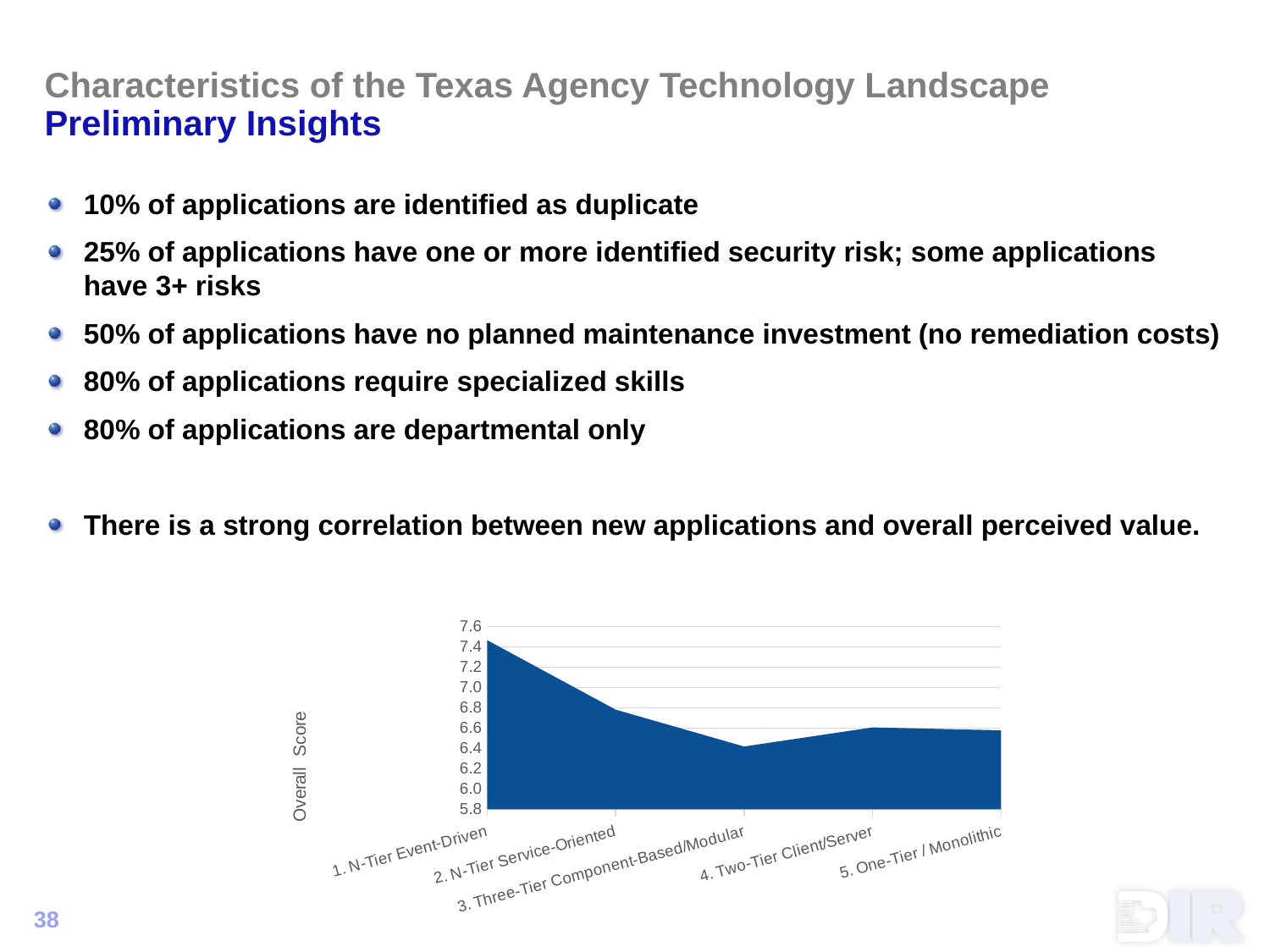
Which has a higher overall score, 1. N-Tier Event-Driven or 2. N-Tier Service-Oriented? 1. N-Tier Event-Driven Which category has the lowest overall score in the chart? 3. Three-Tier Component-Based/Modular What is the lowest value shown on the vertical axis of the chart? 5.8 What is the label on the vertical axis of the chart? Overall Score How many application architecture categories are plotted on the x axis of the chart? 5 Is the overall score for 3. Three-Tier Component-Based/Modular greater or less than 6.6? less Which has a higher overall score, 3. Three-Tier Component-Based/Modular or 4. Two-Tier Client/Server? 4. Two-Tier Client/Server Is the overall score for 2. N-Tier Service-Oriented greater or less than 7.0? less What kind of chart is shown on the slide? Area chart Is the overall score for 1. N-Tier Event-Driven greater or less than 7.0? greater Which category has the highest overall score in the chart? 1. N-Tier Event-Driven